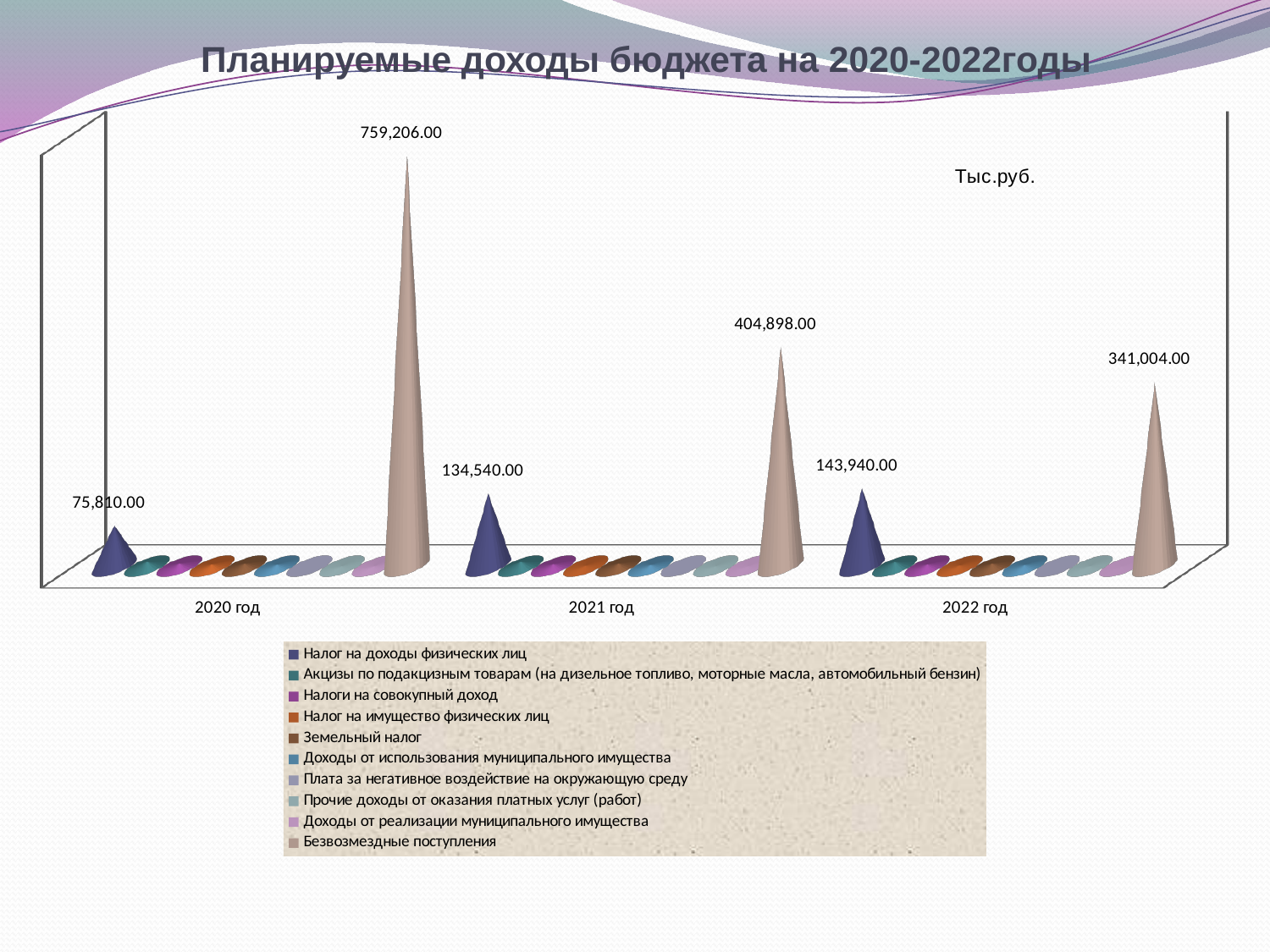
Which year has the larger value of Безвозмездные поступления, 2021 год or 2022 год? 2021 год Does Безвозмездные поступления rise or fall from 2020 год to 2022 год? fall What is the value of Налог на доходы физических лиц for 2022 год? 143,940.00 How many series does the legend list? 10 What is the value of Безвозмездные поступления for 2020 год? 759,206.00 In which year is Безвозмездные поступления the highest? 2020 год What is the value of Налог на доходы физических лиц for 2021 год? 134,540.00 In which year is Налог на доходы физических лиц the lowest? 2020 год What is the value of Безвозмездные поступления for 2022 год? 341,004.00 What is the difference between Безвозмездные поступления in 2020 год and in 2021 год? 354,308.00 What is the difference between Налог на доходы физических лиц in 2022 год and in 2021 год? 9,400.00 How many years (categories) are shown on the x axis? 3